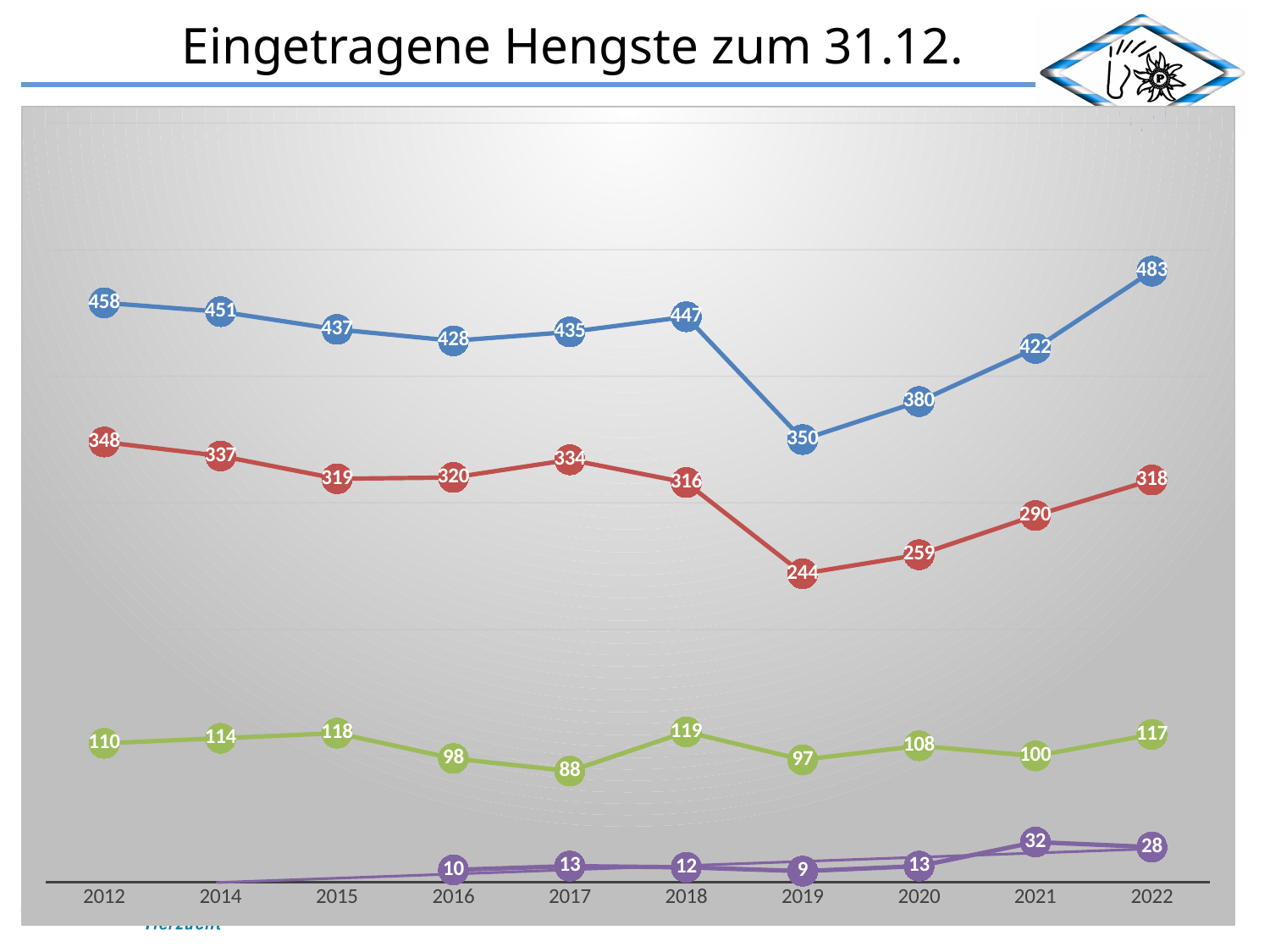
By how much did the blue line's value change from 2018 to 2019? 97 Does the blue line rise or fall from 2019 to 2022? rise What is the value of the blue line in 2019? 350 What kind of chart is shown on the slide? line chart What is the value of the green line in 2017? 88 In which year does the blue line reach its highest value? 2022 How many years are shown on the x axis? 10 Which is larger: the green line's value in 2018 or in 2019? 2018 What is the title of the chart? Eingetragene Hengste zum 31.12. What is the difference between the blue and red values in 2012? 110 In which year does the red line reach its lowest value? 2019 What is the value of the red line in 2022? 318